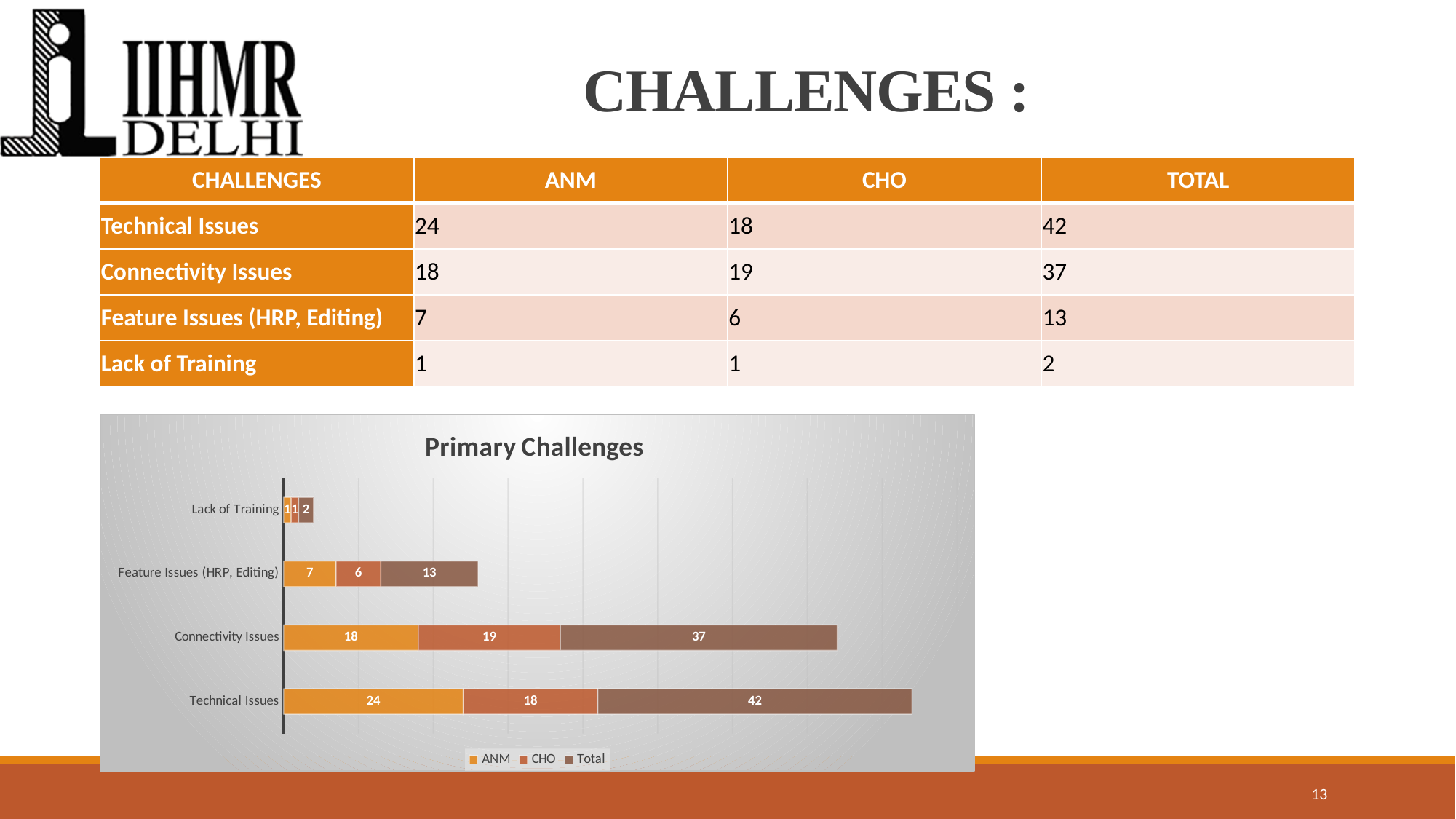
What is the ANM value for Technical Issues in the chart? 24 What type of chart is shown under the title 'Primary Challenges'? bar chart What are the three series named in the chart legend? ANM, CHO, Total Which category has the highest Total value in the chart? Technical Issues What is the title of the chart? Primary Challenges How many series does the chart legend list? 3 What is the CHO value for Connectivity Issues in the chart? 19 How many categories are shown on the chart's vertical axis? 4 What is the difference between the ANM and CHO values for Technical Issues? 6 What is the Total value for Feature Issues (HRP, Editing) in the chart? 13 Which category has the lowest ANM value in the chart? Lack of Training Which is larger for Connectivity Issues, the ANM value or the CHO value? CHO